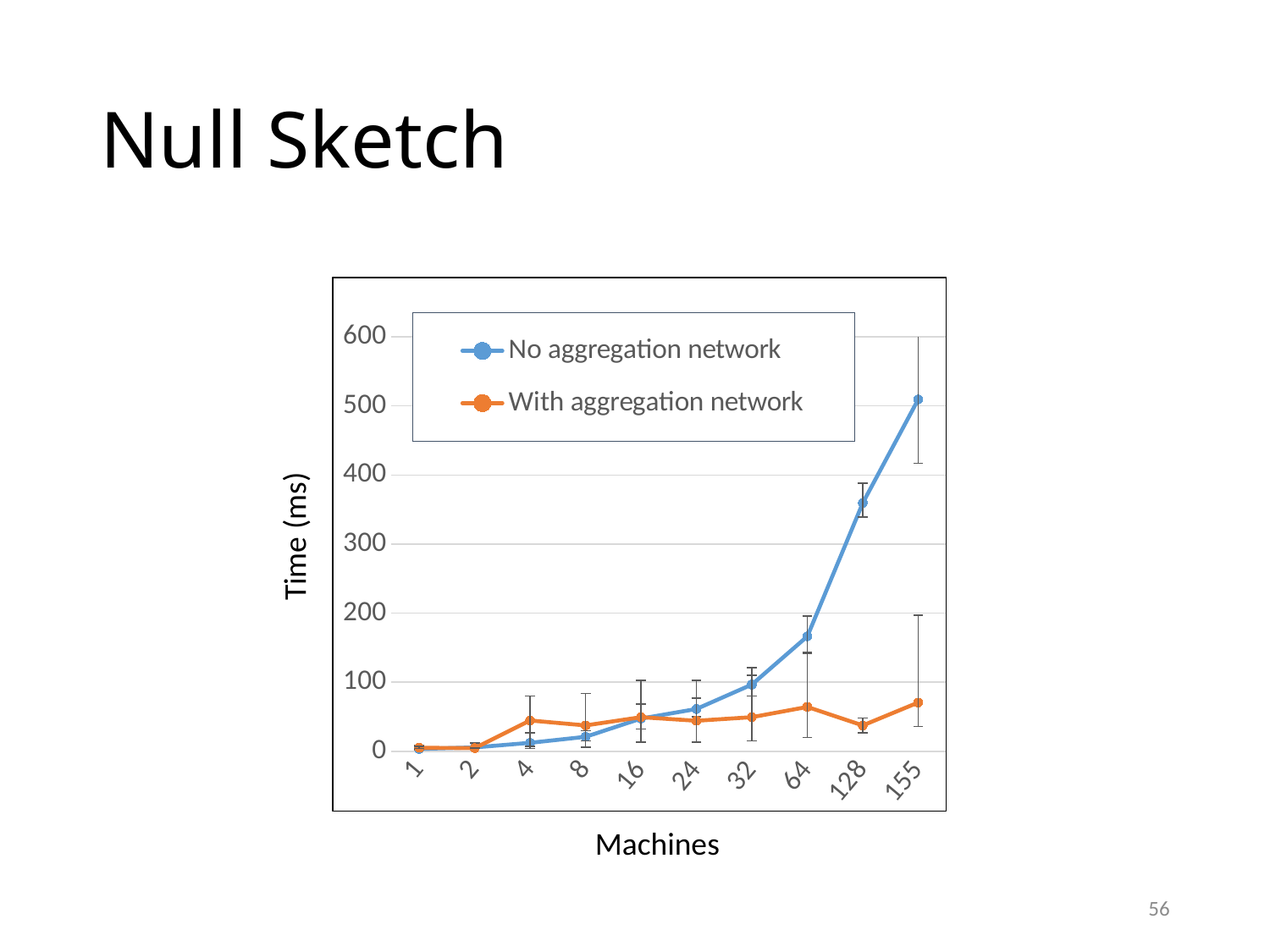
At 155 machines, which series has the larger time: No aggregation network or With aggregation network? No aggregation network Is the value for With aggregation network at 155 machines greater or less than 100? less Is the value for With aggregation network at 128 machines greater or less than 100? less At which number of machines does the No aggregation network series reach its highest value? 155 Does the No aggregation network series rise or fall as the number of machines increases? rise Is the value for No aggregation network at 64 machines greater or less than 100? greater What kind of chart is shown on the slide? line chart How many machine counts are plotted along the x axis? 10 At 4 machines, which series has the larger time: No aggregation network or With aggregation network? With aggregation network How many series does the legend list? 2